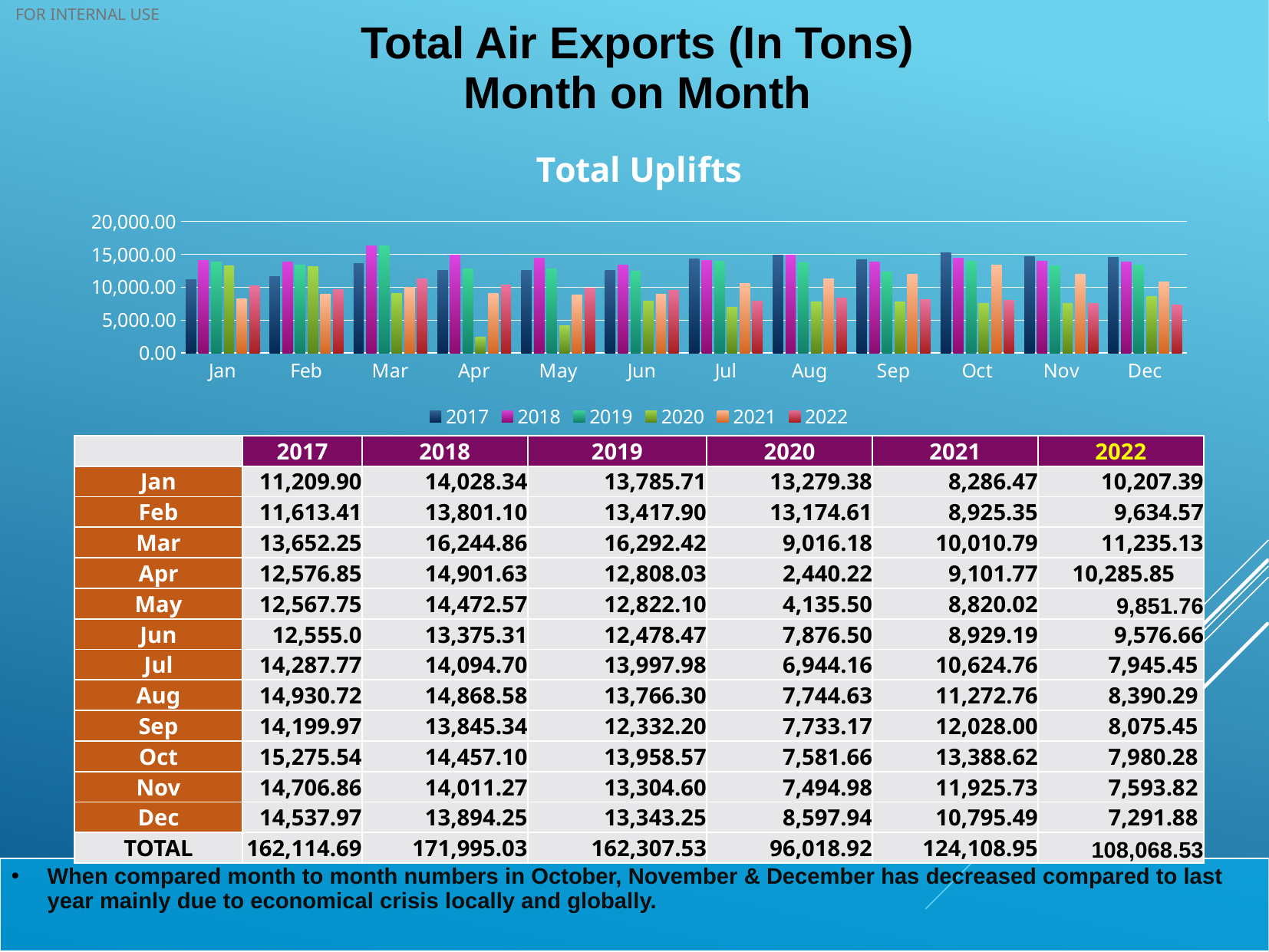
What kind of chart is shown on the slide? bar chart What is the difference between the Jan values for 2017 and 2022? 1,002.51 Do the 2022 values rise or fall from Aug to Dec? fall How many series does the legend of the Total Uplifts chart list? 6 Which is larger in Oct, the value for 2017 or the value for 2022? 2017 What is the value for 2021 in Oct? 13,388.62 Is the value for 2021 in Jan greater or less than 10,000? less How many months are shown along the x axis of the Total Uplifts chart? 12 Which month has the lowest value for 2020? Apr What is the title of the chart? Total Uplifts Which month has the highest value for 2018? Mar What is the value for 2020 in Apr? 2,440.22